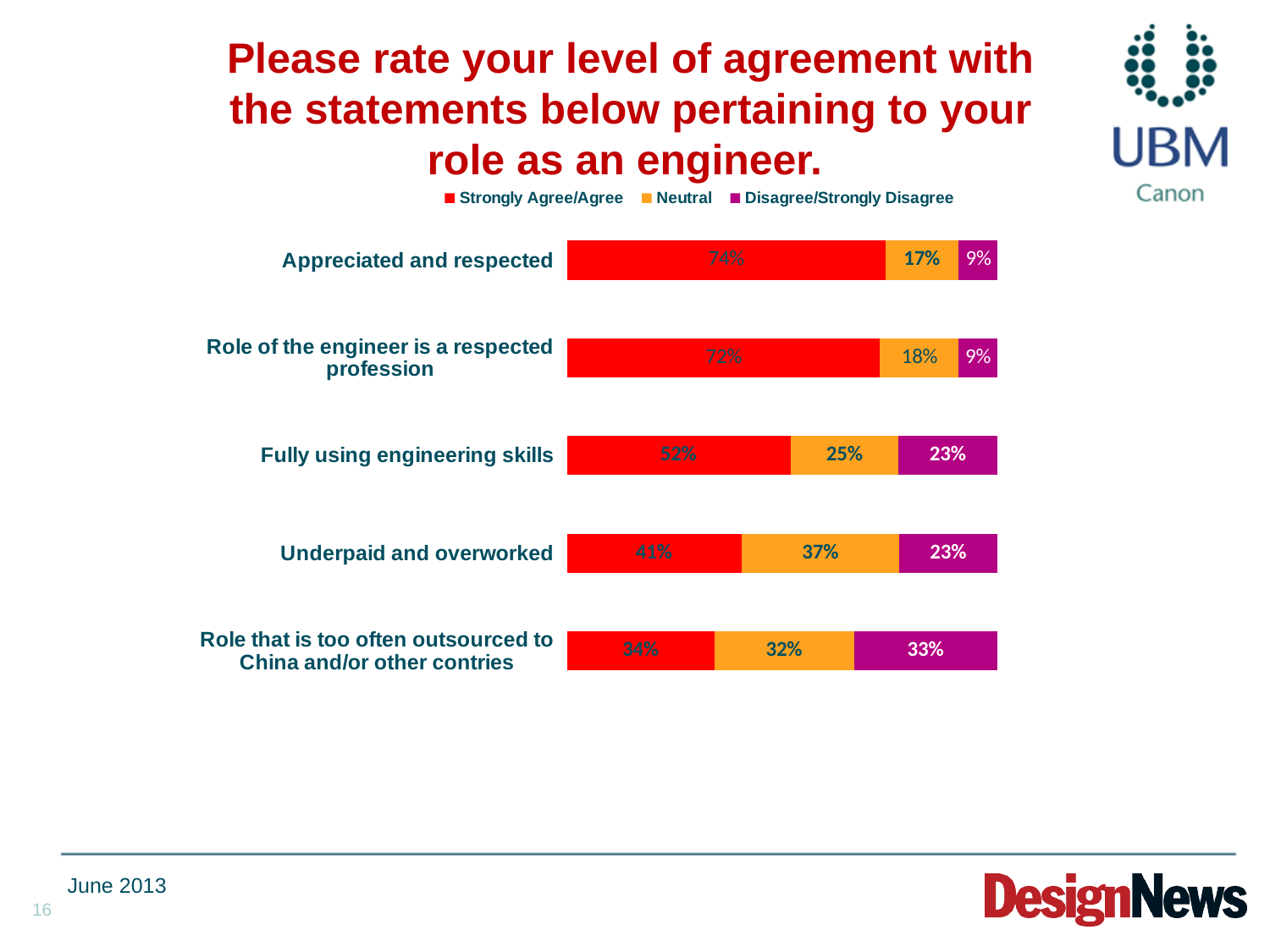
Which statement has the highest Strongly Agree/Agree percentage? Appreciated and respected What is the difference between the Strongly Agree/Agree values for 'Appreciated and respected' and 'Underpaid and overworked'? 33% How many statements are shown in the chart? 5 What is the Neutral value for 'Underpaid and overworked'? 37% What is the Strongly Agree/Agree value for 'Fully using engineering skills'? 52% Which colour represents the Neutral series in the chart? Orange What percentage of respondents Strongly Agree/Agree that they are Appreciated and respected? 74% Which statement has the lowest Strongly Agree/Agree percentage? Role that is too often outsourced to China and/or other contries What kind of chart is shown on the slide? Stacked bar chart Which has a larger Neutral value: 'Fully using engineering skills' or 'Underpaid and overworked'? Underpaid and overworked How many series does the legend list? 3 What is the Disagree/Strongly Disagree value for 'Role that is too often outsourced to China and/or other contries'? 33%